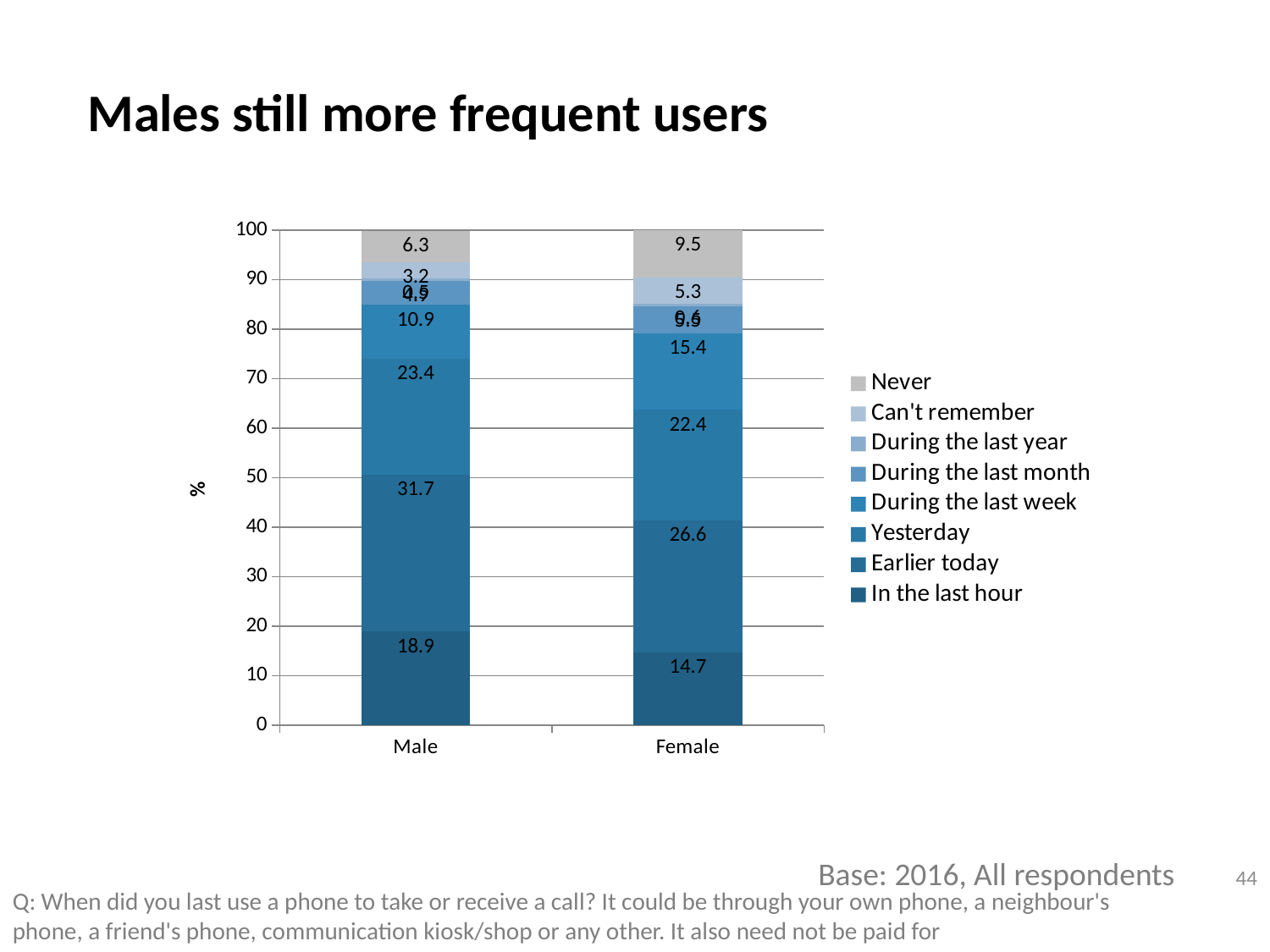
Which segment is the largest in the Male bar? Earlier today What is the value for 'Never' for Female? 9.5 What is the value for 'During the last week' for Male? 10.9 How many series does the legend list? 8 Which group has the larger 'Never' value, Male or Female? Female What is the value for 'In the last hour' for Male? 18.9 How many categories are shown on the x axis? 2 What is the difference between the 'Earlier today' values for Male and Female? 5.1 Which group has the larger 'Yesterday' value, Male or Female? Male What is the value for 'Earlier today' for Female? 26.6 What kind of chart is shown on the slide? Stacked bar chart What is the value for 'Can't remember' for Female? 5.3